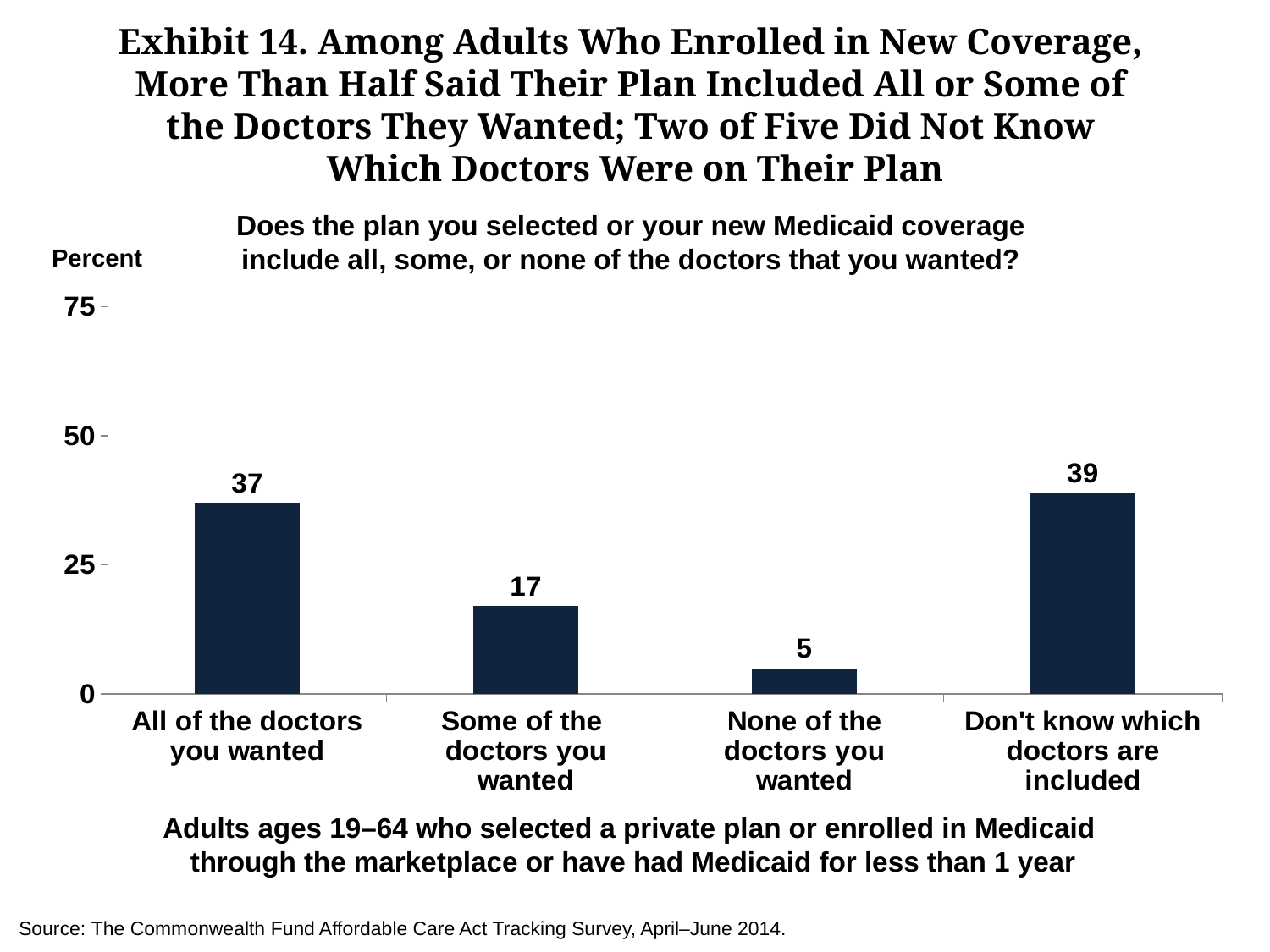
What kind of chart is shown on the slide? Bar chart What percent of adults said their plan included all of the doctors they wanted? 37 What percent of adults said their plan included none of the doctors they wanted? 5 What is the difference between the value for 'All of the doctors you wanted' and 'Some of the doctors you wanted'? 20 What percent of adults said they don't know which doctors are included? 39 Which response category has the highest value? Don't know which doctors are included Which is larger: the value for 'All of the doctors you wanted' or 'Don't know which doctors are included'? Don't know which doctors are included Which response category has the lowest value? None of the doctors you wanted What percent of adults said their plan included some of the doctors they wanted? 17 Is the value for 'Some of the doctors you wanted' greater or less than 25? less How many response categories are shown on the chart? 4 What is the label on the vertical axis of the chart? Percent